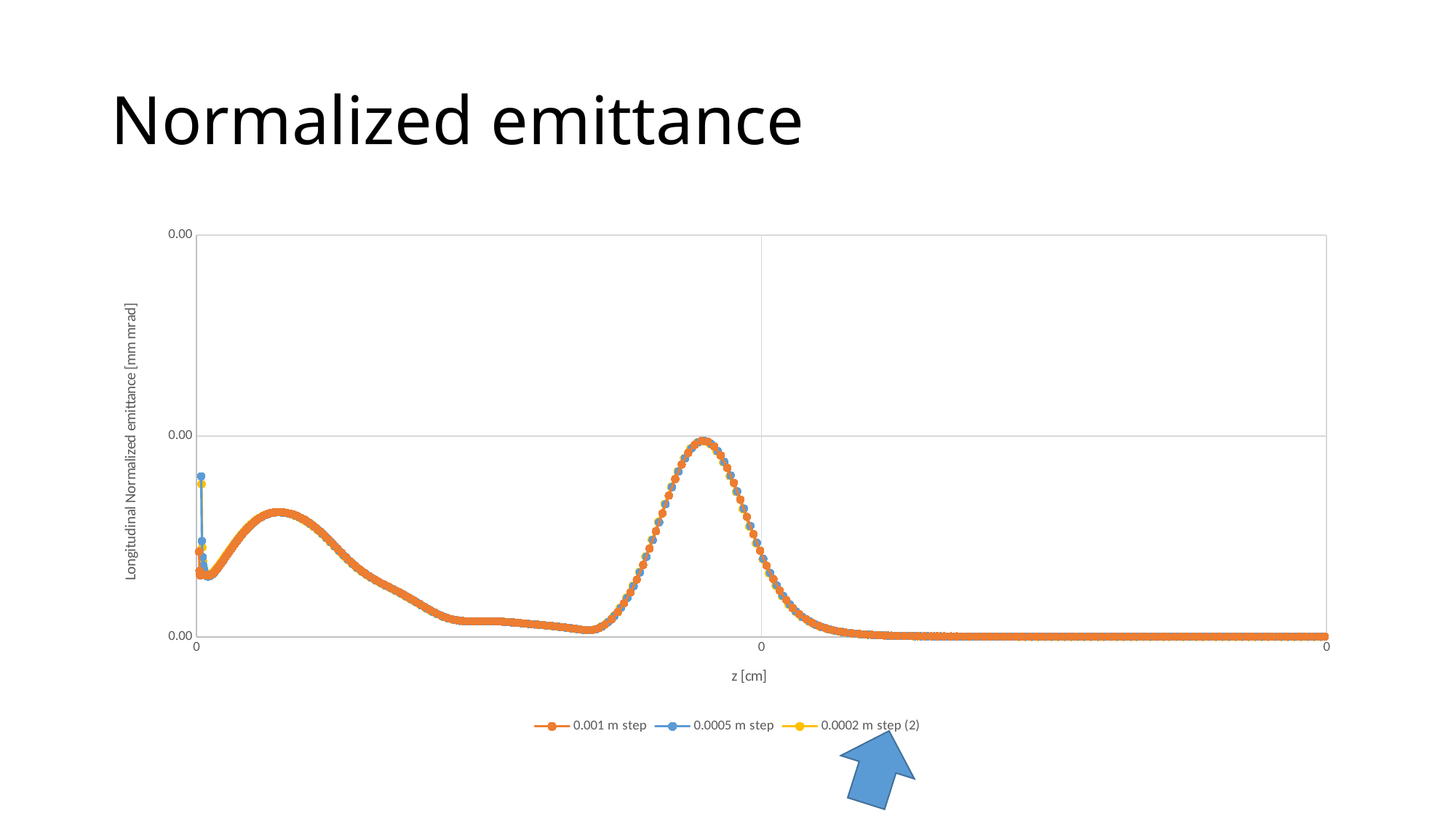
How many series does the legend list? 3 What kind of chart is shown on the slide? line chart After the tallest peak, does the line rise or fall toward the right edge of the chart? fall What is the title of the x axis? z [cm] What are the three series names listed in the legend? 0.001 m step, 0.0005 m step, 0.0002 m step (2)